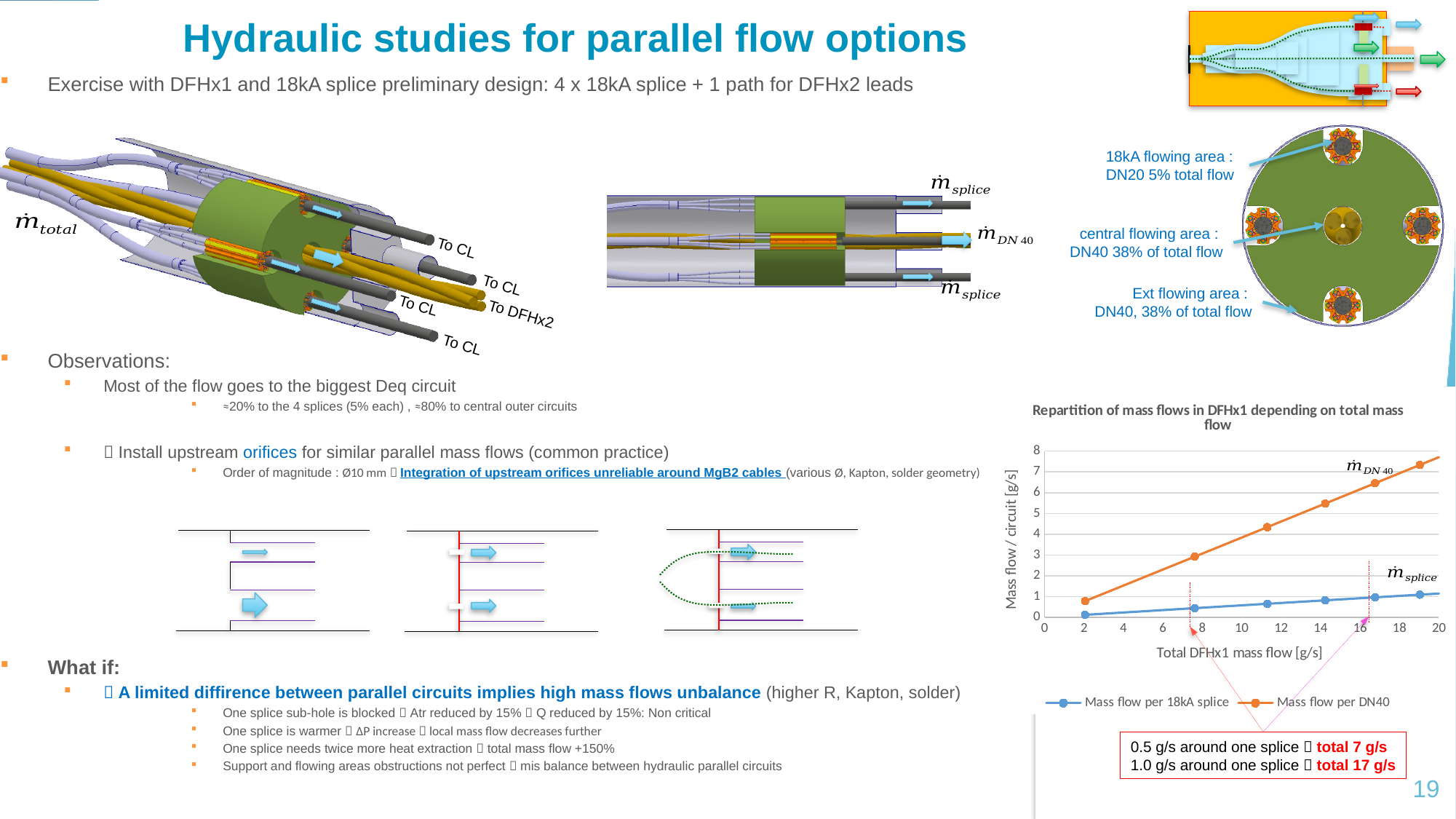
Do the values of the Mass flow per 18kA splice series rise or fall along the x axis? rise Is the value of Mass flow per DN40 at a total mass flow of 19 g/s greater or less than 6? greater Which series has the higher values across the chart, Mass flow per 18kA splice or Mass flow per DN40? Mass flow per DN40 Do the values of the Mass flow per DN40 series rise or fall as the total DFHx1 mass flow increases? rise Is the value of Mass flow per 18kA splice at a total mass flow of 19 g/s greater or less than 2? less What is the label of the x axis of the chart? Total DFHx1 mass flow [g/s] What is the title of the chart? Repartition of mass flows in DFHx1 depending on total mass flow How many series does the legend of the chart list? 2 Is the value of Mass flow per 18kA splice at a total mass flow of 2 g/s greater or less than 1? less What kind of chart is shown on the slide? line chart How many data points are plotted for the Mass flow per DN40 series? 6